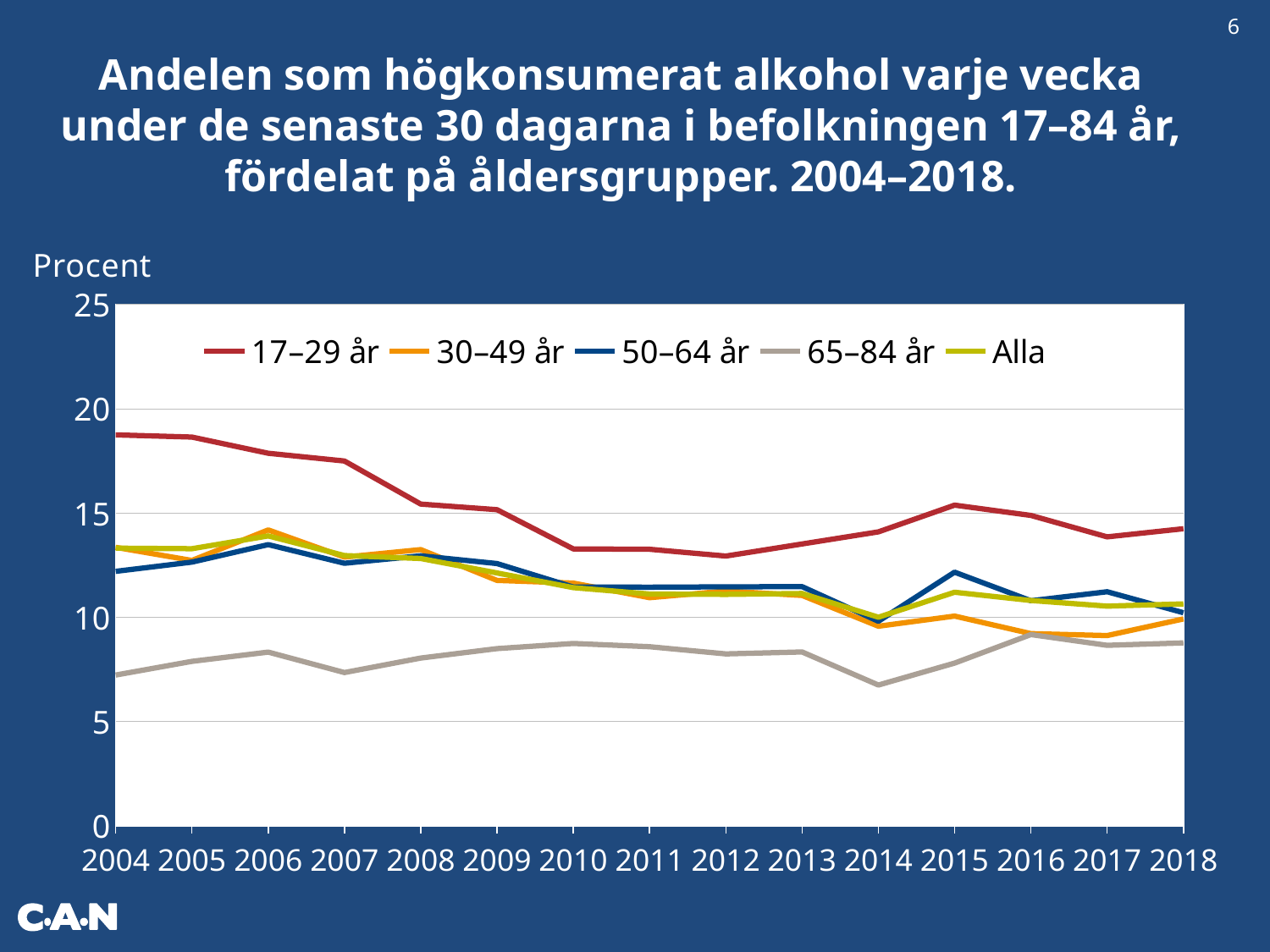
Which is larger in 2018, the value for 17–29 år or the value for 65–84 år? 17–29 år Which age group has the highest value in 2004? 17–29 år Is the value for 17–29 år in 2004 greater or less than 15? greater Does the value for 17–29 år rise or fall from 2004 to 2012? fall What kind of chart is shown on the slide? line chart Is the value for 17–29 år in 2010 greater or less than 15? less How many series does the legend list? 5 How many years are shown on the x axis? 15 What colour is the line for 17–29 år? red What is the label shown above the y axis? Procent Is the value for 65–84 år in 2014 greater or less than 10? less Which age group has the lowest value in 2004? 65–84 år